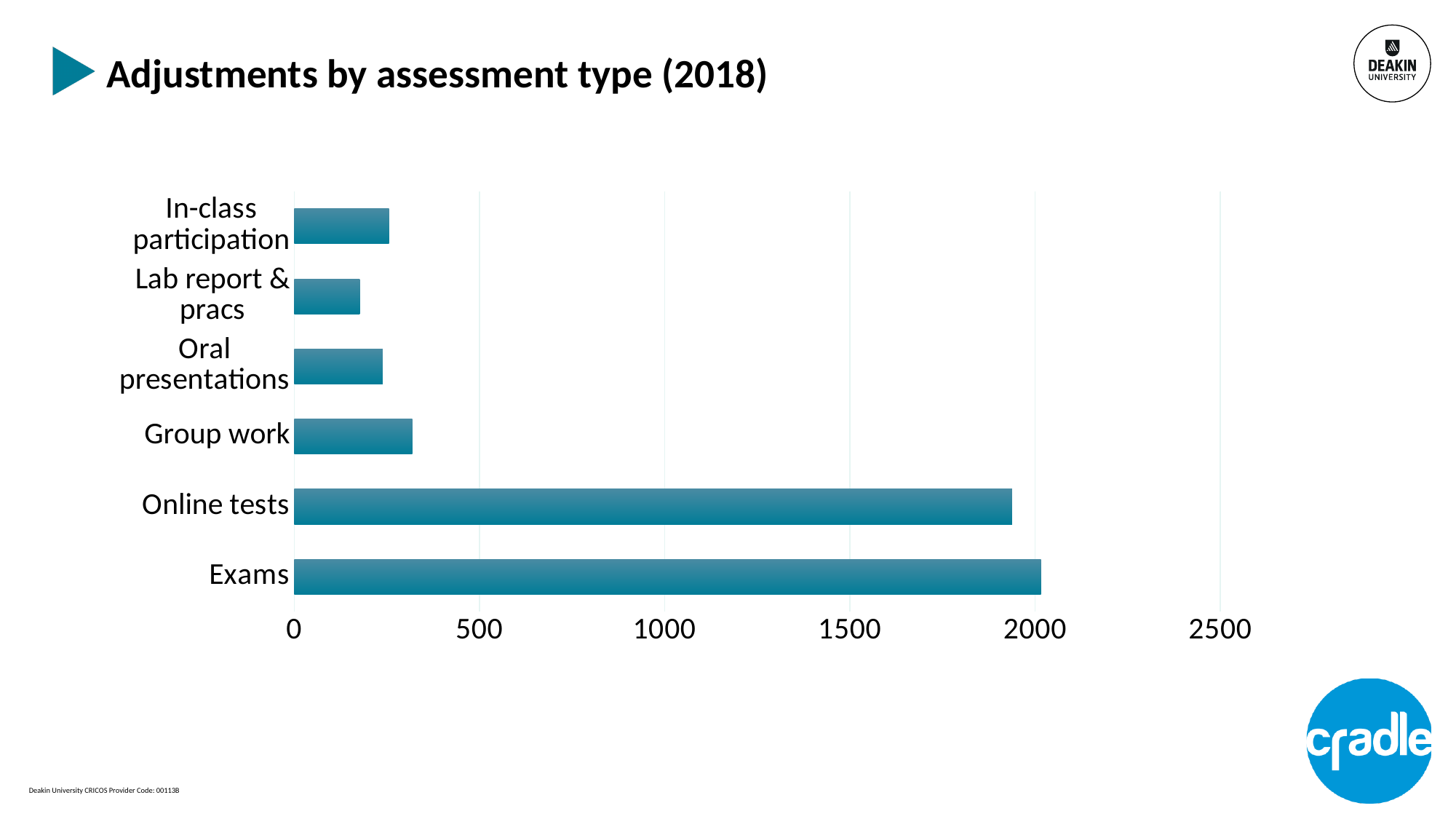
What kind of chart is shown on the slide? bar chart Which has more adjustments, Oral presentations or Lab report & pracs? Oral presentations What is the title of the chart? Adjustments by assessment type (2018) What is the highest value shown on the horizontal axis? 2500 Is the value for Online tests greater or less than 1500? greater Is the value for Online tests greater or less than 2000? less Is the value for Group work greater or less than 500? less Which has more adjustments, Group work or In-class participation? Group work Which assessment type has the lowest number of adjustments? Lab report & pracs Which assessment type has the highest number of adjustments? Exams How many assessment types are shown in the chart? 6